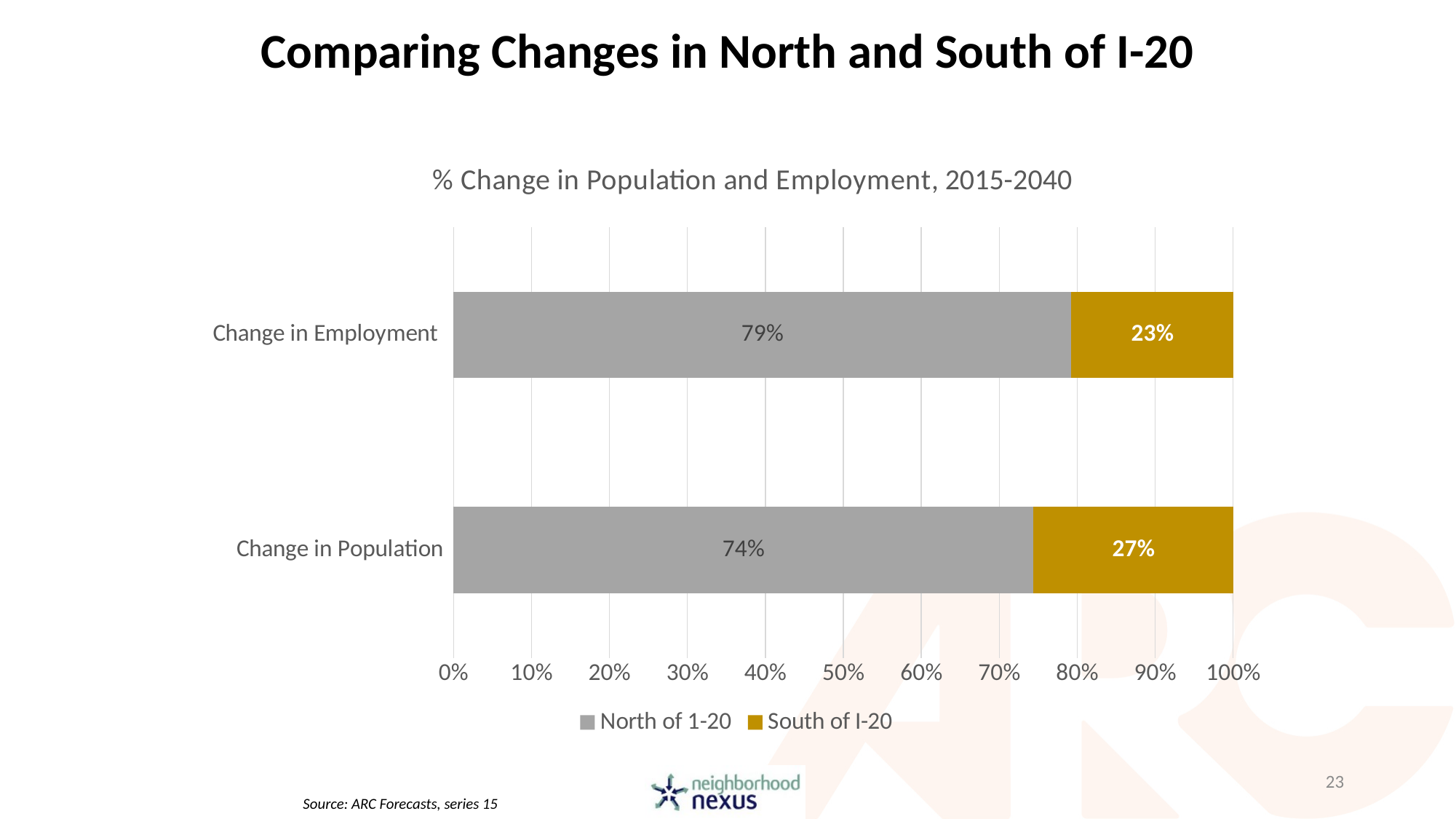
What is the value for North of 1-20 in the Change in Employment bar? 79% What kind of chart is shown on the slide? Stacked bar chart What is the value for North of 1-20 in the Change in Population bar? 74% How many categories are shown on the chart? 2 What is the title of the chart? % Change in Population and Employment, 2015-2040 Which category has the lower South of I-20 value? Change in Employment How many series does the legend list? 2 What is the difference between the North of 1-20 values for Change in Employment and Change in Population? 5% Which category has the higher North of 1-20 value? Change in Employment Is the South of I-20 value for Change in Population larger or smaller than the South of I-20 value for Change in Employment? larger What is the value for South of I-20 in the Change in Population bar? 27% What is the value for South of I-20 in the Change in Employment bar? 23%